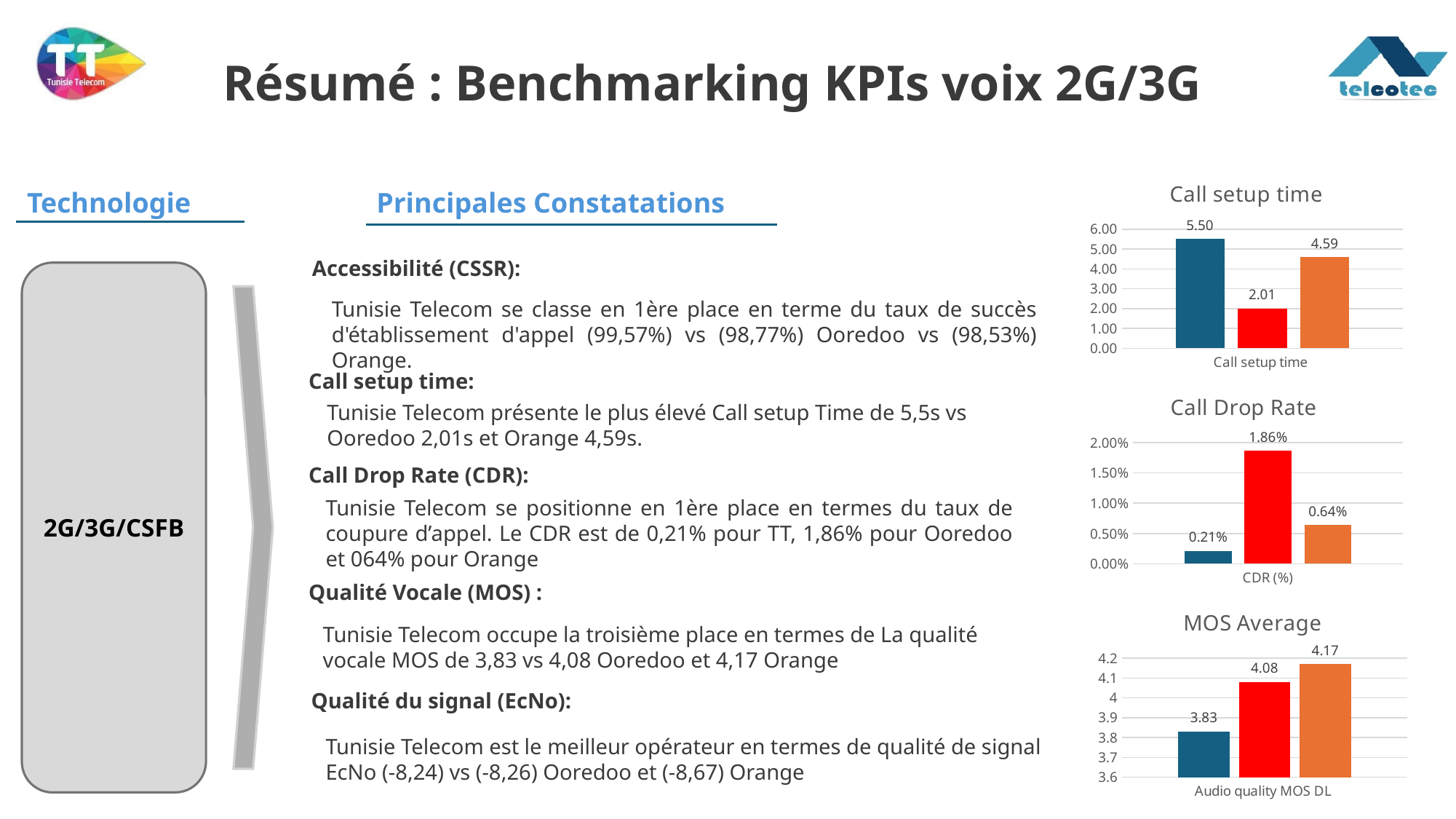
What kind of chart is the MOS Average chart? Bar chart In the Call Drop Rate chart, what is the value of the red bar? 1.86% What is the x-axis category label shown under the bars in the Call Drop Rate chart? CDR (%) In the Call Drop Rate chart, which bar has the lowest value? The blue bar (0.21%) In the Call setup time chart, what is the value of the tallest bar? 5.50 In the MOS Average chart, which is larger, the blue bar or the red bar? The red bar (4.08) In the Call setup time chart, what is the value of the red bar? 2.01 In the Call setup time chart, what is the difference between the blue bar and the orange bar? 0.91 In the Call Drop Rate chart, what is the difference between the red bar and the orange bar? 1.22% In the MOS Average chart, what is the value of the orange bar? 4.17 In the Call Drop Rate chart, is the orange bar greater or less than 0.50%? greater In the Call setup time chart, how many bars are plotted? 3